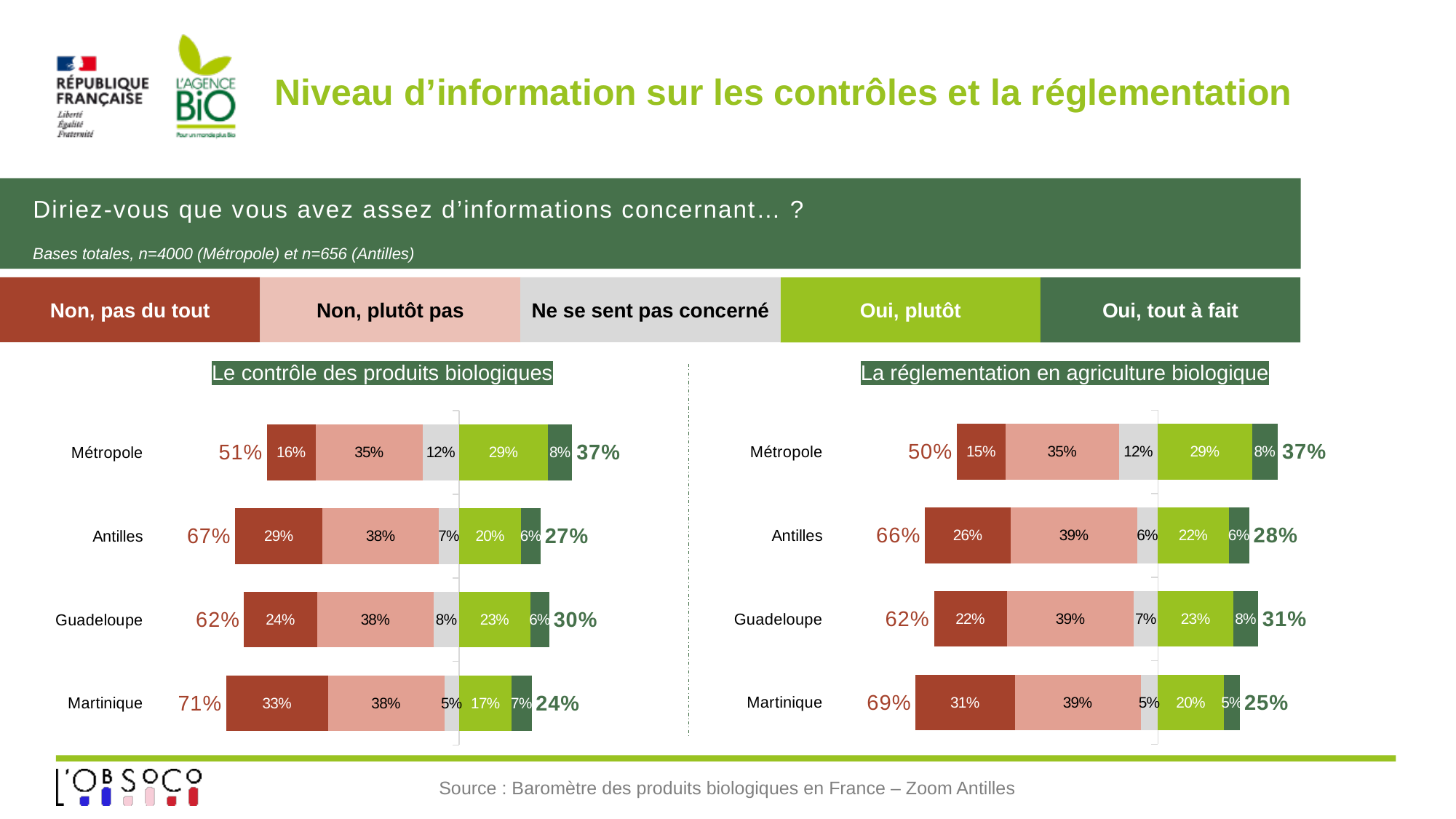
In the chart 'La réglementation en agriculture biologique', is the 'Oui, plutôt' share larger for Guadeloupe or for Martinique? Guadeloupe Which colour represents 'Oui, tout à fait' in the legend? Dark green In the chart 'La réglementation en agriculture biologique', which region has the lowest 'Ne se sent pas concerné' share? Martinique In the chart 'Le contrôle des produits biologiques', what percentage of Antilles respondents answered 'Non, pas du tout'? 29% In the chart 'La réglementation en agriculture biologique', what percentage of Martinique respondents answered 'Oui, plutôt'? 20% In the chart 'Le contrôle des produits biologiques', what is the combined 'Non' total (Non, pas du tout + Non, plutôt pas) shown for Guadeloupe? 62% In the chart 'Le contrôle des produits biologiques', what is the difference between the 'Non, pas du tout' shares for Martinique and Métropole? 17 percentage points How many regions are shown in the chart 'Le contrôle des produits biologiques'? 4 How many response categories does the legend list? 5 What kind of chart is 'La réglementation en agriculture biologique'? Stacked bar chart In the chart 'La réglementation en agriculture biologique', what is the combined 'Oui' total shown for Antilles? 28% In the chart 'Le contrôle des produits biologiques', which region has the highest 'Non, pas du tout' share? Martinique